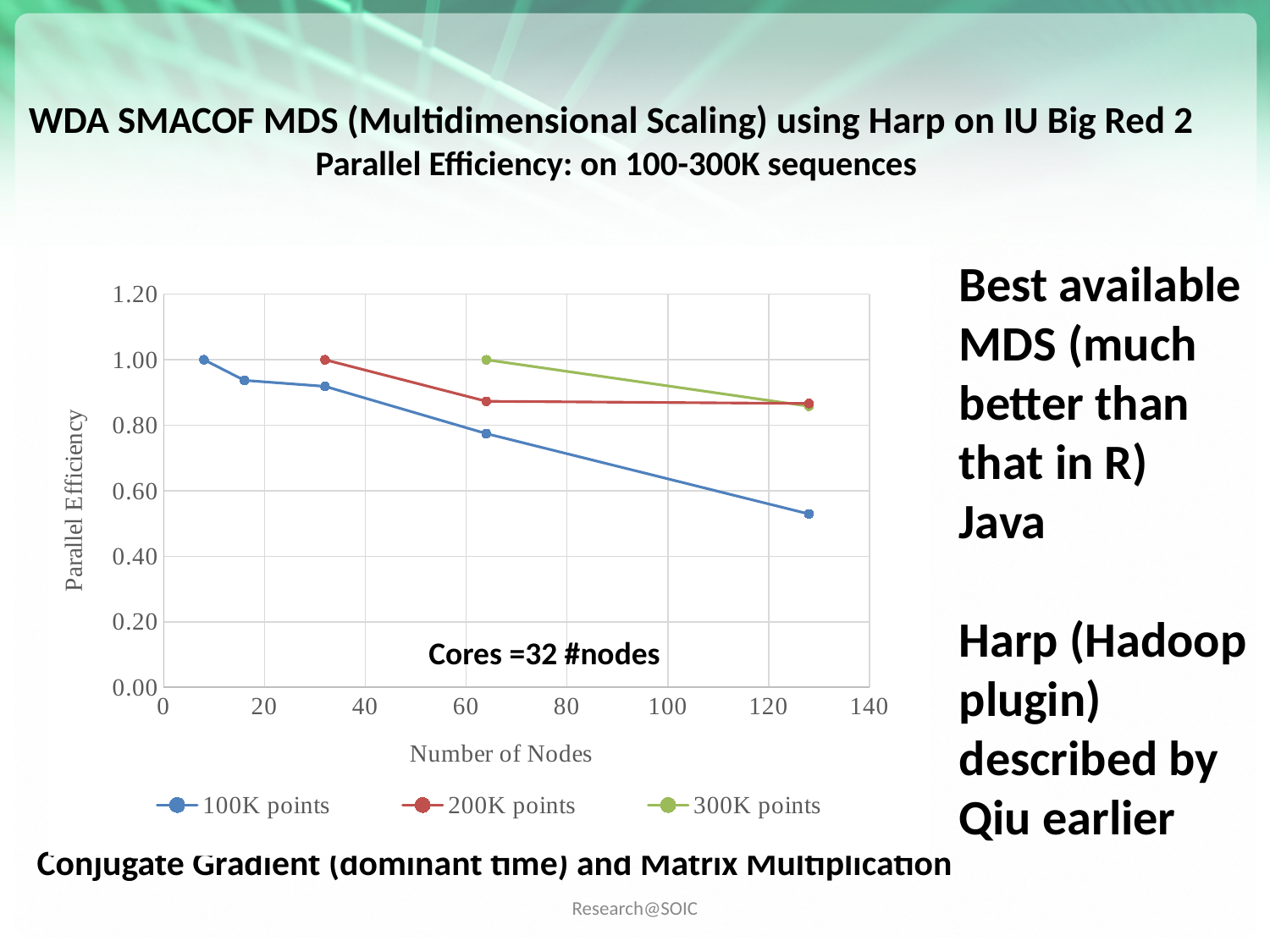
What kind of chart is shown on the slide? line chart How many data points are plotted for the 200K points series? 3 What is the title of the x axis? Number of Nodes Which series has the lowest parallel efficiency at 128 nodes? 100K points How many series does the legend list? 3 Does the parallel efficiency for the 100K points series rise or fall as the number of nodes increases? fall Is the parallel efficiency for 200K points at 128 nodes greater or less than 0.80? greater At 128 nodes, which series has the higher parallel efficiency, 100K points or 200K points? 200K points Is the parallel efficiency for 100K points at 64 nodes greater or less than 0.60? greater How many data points are plotted for the 100K points series? 5 Is the parallel efficiency for 100K points at 128 nodes greater or less than 0.60? less What is the title of the y axis? Parallel Efficiency